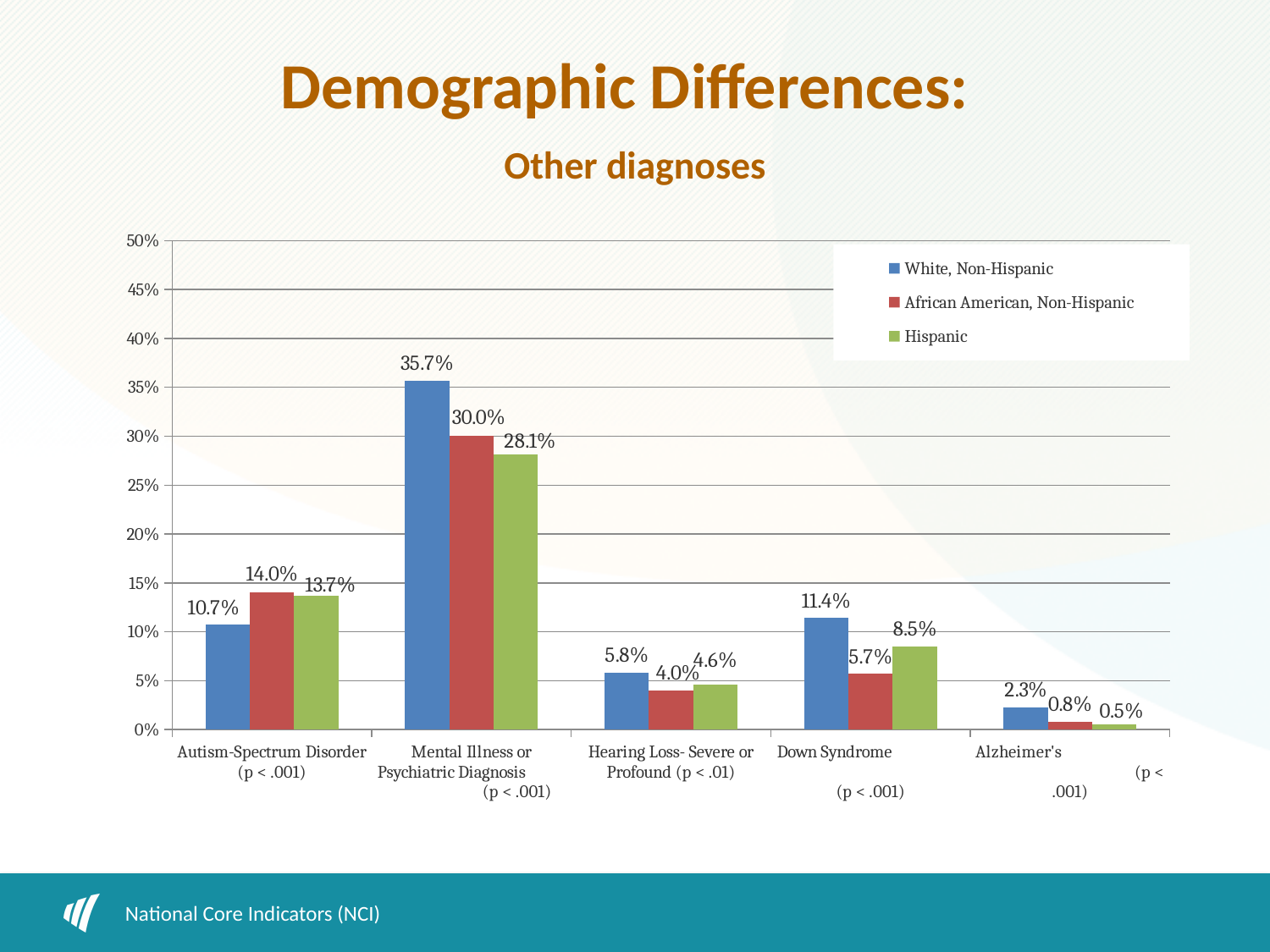
How many diagnosis categories are shown on the x axis? 5 Which diagnosis category has the highest value for the Hispanic series? Mental Illness or Psychiatric Diagnosis For Autism-Spectrum Disorder, which is larger: the White, Non-Hispanic value or the Hispanic value? Hispanic Which colour represents the Hispanic series in the chart? green Is the African American, Non-Hispanic value for Mental Illness or Psychiatric Diagnosis greater or less than 25%? greater What kind of chart is shown on the slide? bar chart What is the difference between the White, Non-Hispanic and African American, Non-Hispanic values for Down Syndrome? 5.7% What is the value for Hispanic for Down Syndrome? 8.5% Which diagnosis category has the lowest value for the White, Non-Hispanic series? Alzheimer's How many series does the legend list? 3 What is the value for White, Non-Hispanic for Mental Illness or Psychiatric Diagnosis? 35.7% What is the value for African American, Non-Hispanic for Autism-Spectrum Disorder? 14.0%